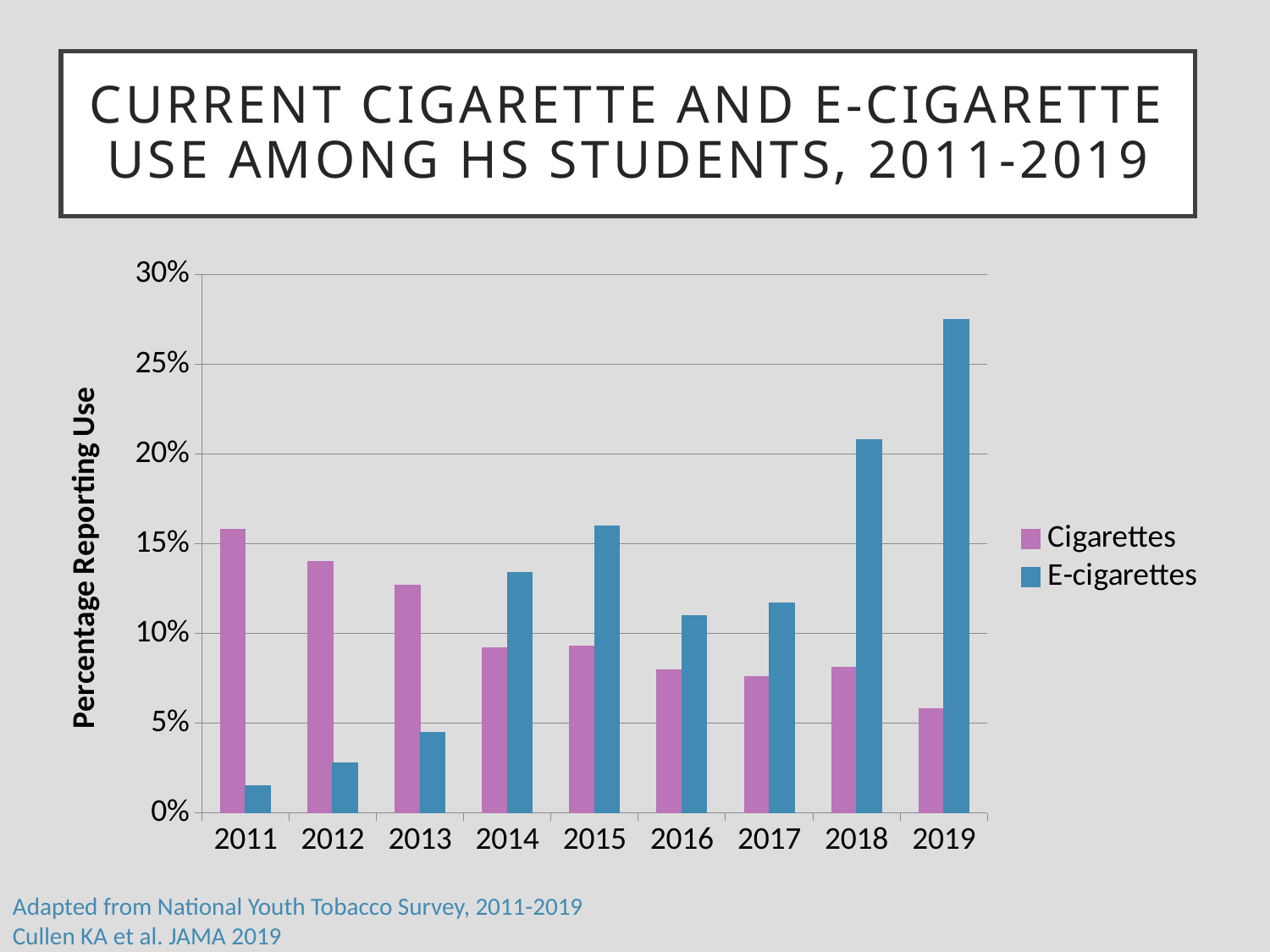
In 2014, which is larger: the Cigarettes value or the E-cigarettes value? E-cigarettes Is the Cigarettes value for 2013 greater or less than 10%? greater What is the title of the y axis? Percentage Reporting Use In 2012, which is larger: the Cigarettes value or the E-cigarettes value? Cigarettes Is the E-cigarettes value for 2019 greater or less than 25%? greater What kind of chart is shown on the slide? Bar chart In which year is the Cigarettes value highest? 2011 How many series does the legend list? 2 How many years are shown on the x axis? 9 In which year is the Cigarettes value lowest? 2019 In which year is the E-cigarettes value highest? 2019 In which year is the E-cigarettes value lowest? 2011